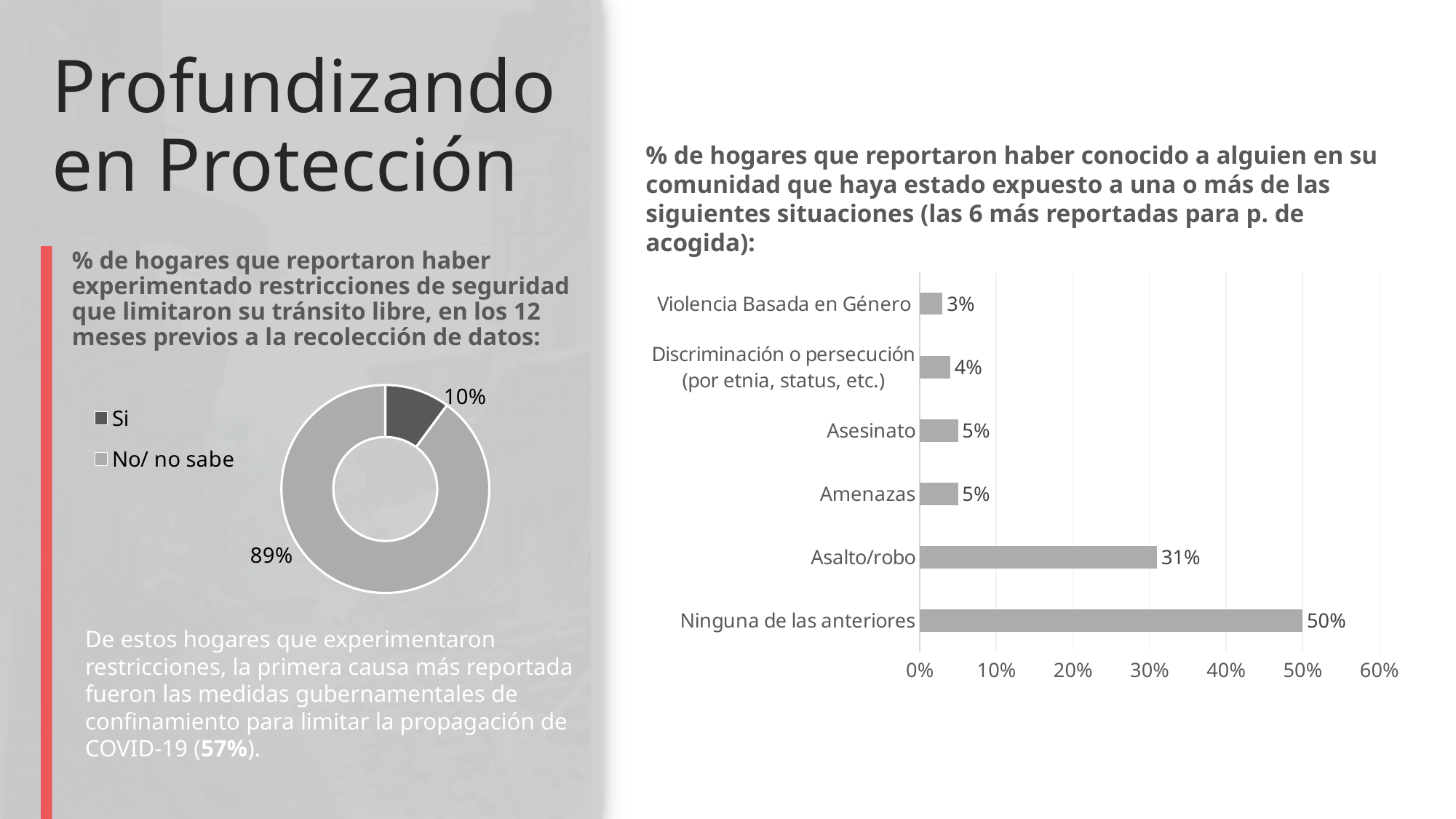
How many entries does the legend of the donut chart on the left list? 2 How many categories does the bar chart on the right show? 6 In the donut chart on the left, what is the value for Si? 10% In the donut chart on the left, what is the value for No/ no sabe? 89% In the donut chart on the left, which slice is larger: Si or No/ no sabe? No/ no sabe In the bar chart on the right, what is the difference between Ninguna de las anteriores and Asalto/robo? 19% In the bar chart on the right, what is the value for Violencia Basada en Género? 3% In the bar chart on the right, which is larger: Discriminación o persecución or Asesinato? Asesinato What kind of chart is the chart on the right side of the slide? Bar chart In the bar chart on the right, what is the value for Asalto/robo? 31% In the bar chart on the right, which category has the highest value? Ninguna de las anteriores In the bar chart on the right, which category has the lowest value? Violencia Basada en Género